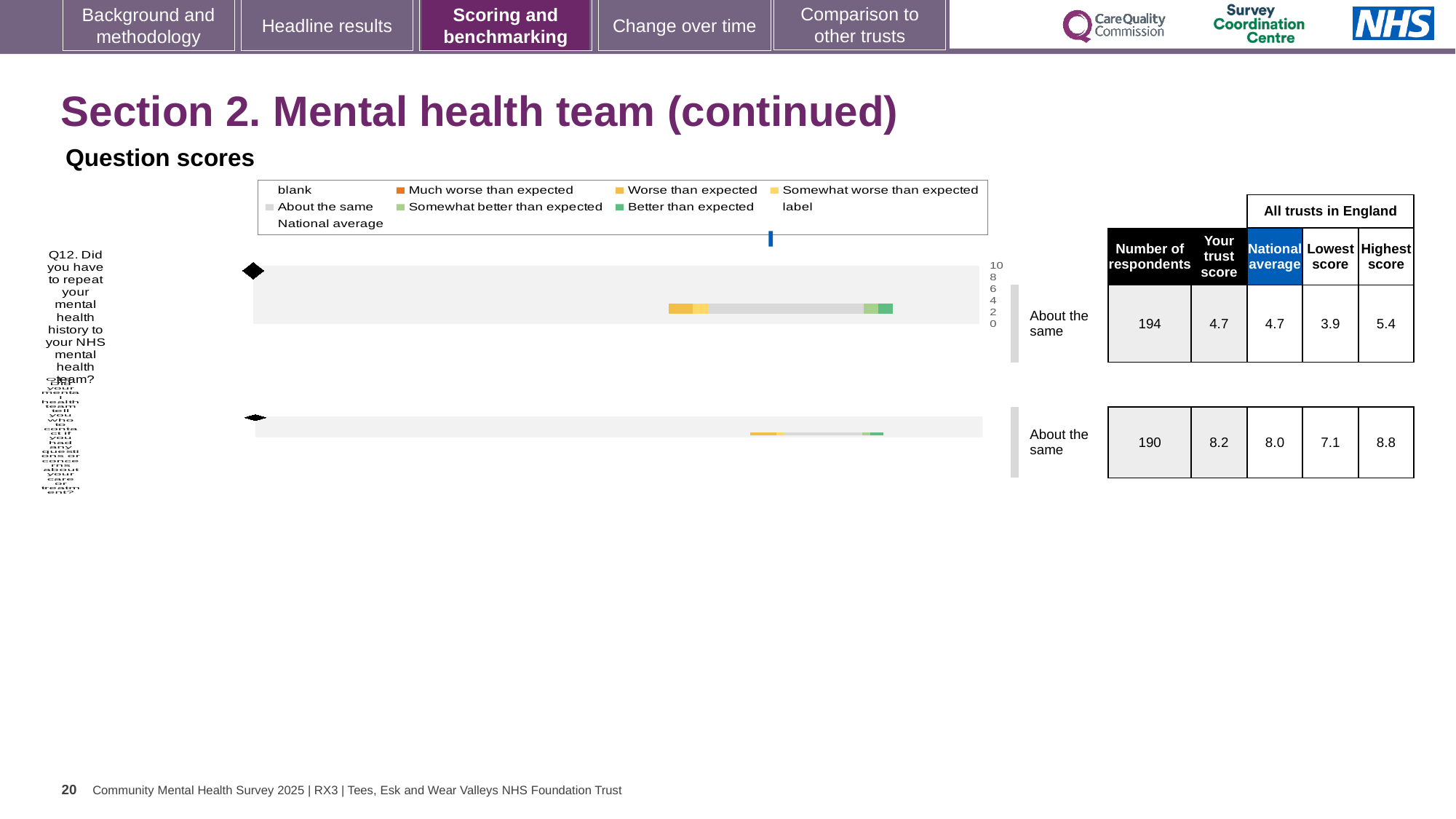
For Q12, how many respondents are shown in the table beside the chart? 194 In the legend, what colour represents 'Much worse than expected'? orange For Q12, what is the difference between the highest score (5.4) and the lowest score (3.9) among all trusts? 1.5 For the lower chart, what benchmark category is shown next to the bar? About the same In the legend, what colour represents 'Better than expected'? green For Q12, what is the trust's score shown in the table beside the chart? 4.7 For the lower chart, what is the difference between the trust score (8.2) and the national average (8.0)? 0.2 What kind of chart is used to show the Q12 benchmark result? bar chart How many question bars (charts) are shown on the slide? 2 For the lower chart, which is larger: the trust score or the national average? the trust score (8.2) For the Q12 chart, what benchmark category is shown next to the bar? About the same For Q12, what is the highest score among all trusts in England? 5.4